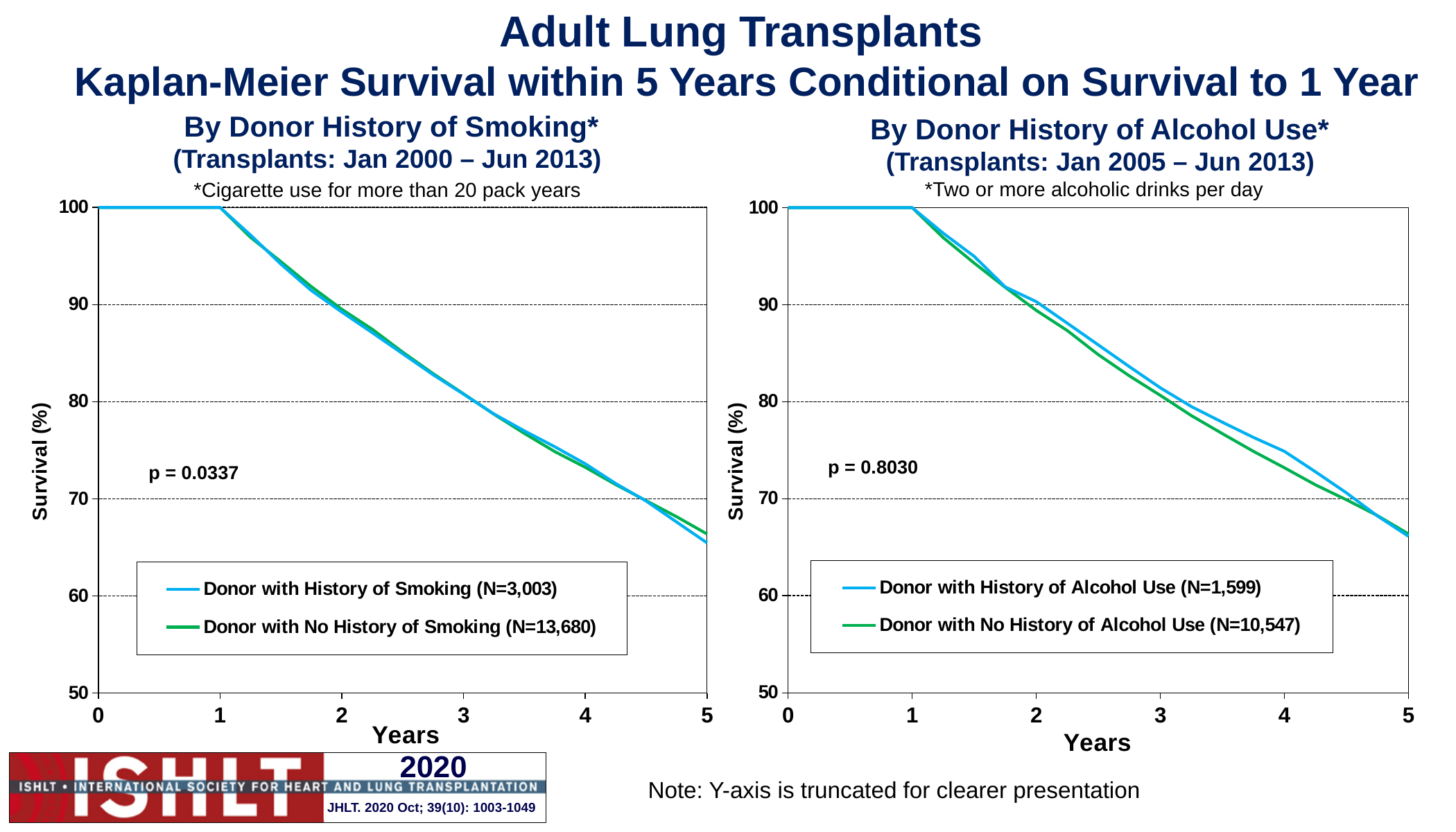
In the right chart, 'By Donor History of Alcohol Use', is the survival value for donors with no history of alcohol use at year 5 greater or less than 70? less In the left chart, 'By Donor History of Smoking', what is the survival value for donors with a history of smoking at year 1? 100 In the right chart, 'By Donor History of Alcohol Use', is the survival value for donors with a history of alcohol use at year 4 greater or less than 70? greater In the left chart, 'By Donor History of Smoking', is the survival value for donors with a history of smoking at year 5 greater or less than 70? less What is the N for the 'Donor with History of Alcohol Use' series in the right chart's legend? N=1,599 In the left chart, 'By Donor History of Smoking', do the survival curves rise or fall as years increase from 1 to 5? fall What kind of chart is the left chart, 'By Donor History of Smoking'? line chart What p-value is shown on the left chart, 'By Donor History of Smoking'? p = 0.0337 In the right chart, 'By Donor History of Alcohol Use', do the survival curves rise or fall as years increase from 1 to 5? fall How many series does the legend of the right chart, 'By Donor History of Alcohol Use', list? 2 How many series does the legend of the left chart, 'By Donor History of Smoking', list? 2 In the right chart, 'By Donor History of Alcohol Use', what is the survival value for donors with no history of alcohol use at year 0? 100